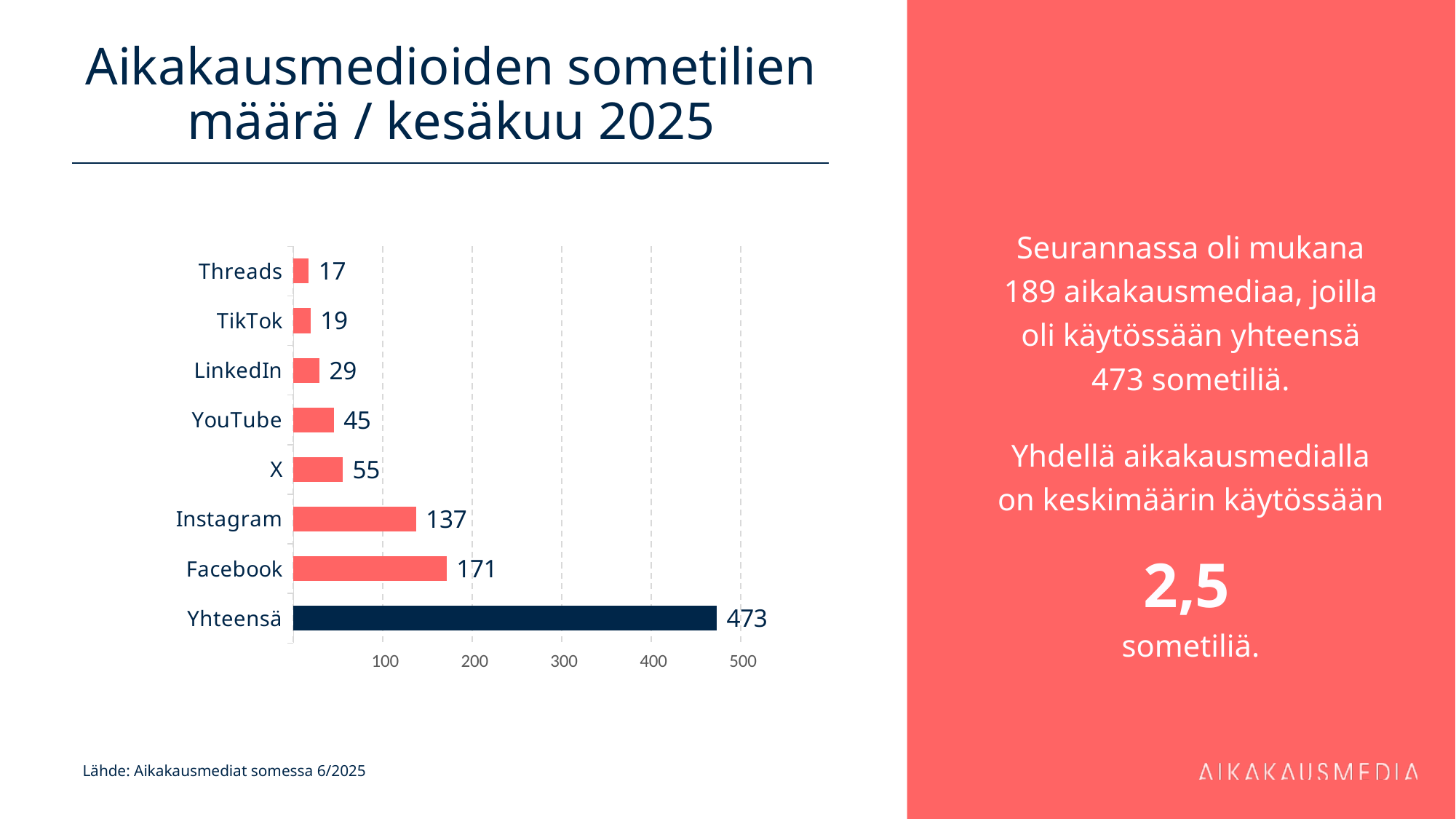
Which is larger, the value for X or the value for YouTube? X How many bars are shown in the chart? 8 What is the value for Instagram? 137 What is the value for Facebook? 171 What is the difference between the values for Facebook and Instagram? 34 What is the title of the slide? Aikakausmedioiden sometilien määrä / kesäkuu 2025 Which individual platform (excluding Yhteensä) has the highest value? Facebook What kind of chart is shown on the slide? Bar chart Is the value for Instagram greater or less than 100? greater Which platform has the lowest value? Threads What is the value shown for Yhteensä? 473 What is the value for LinkedIn? 29